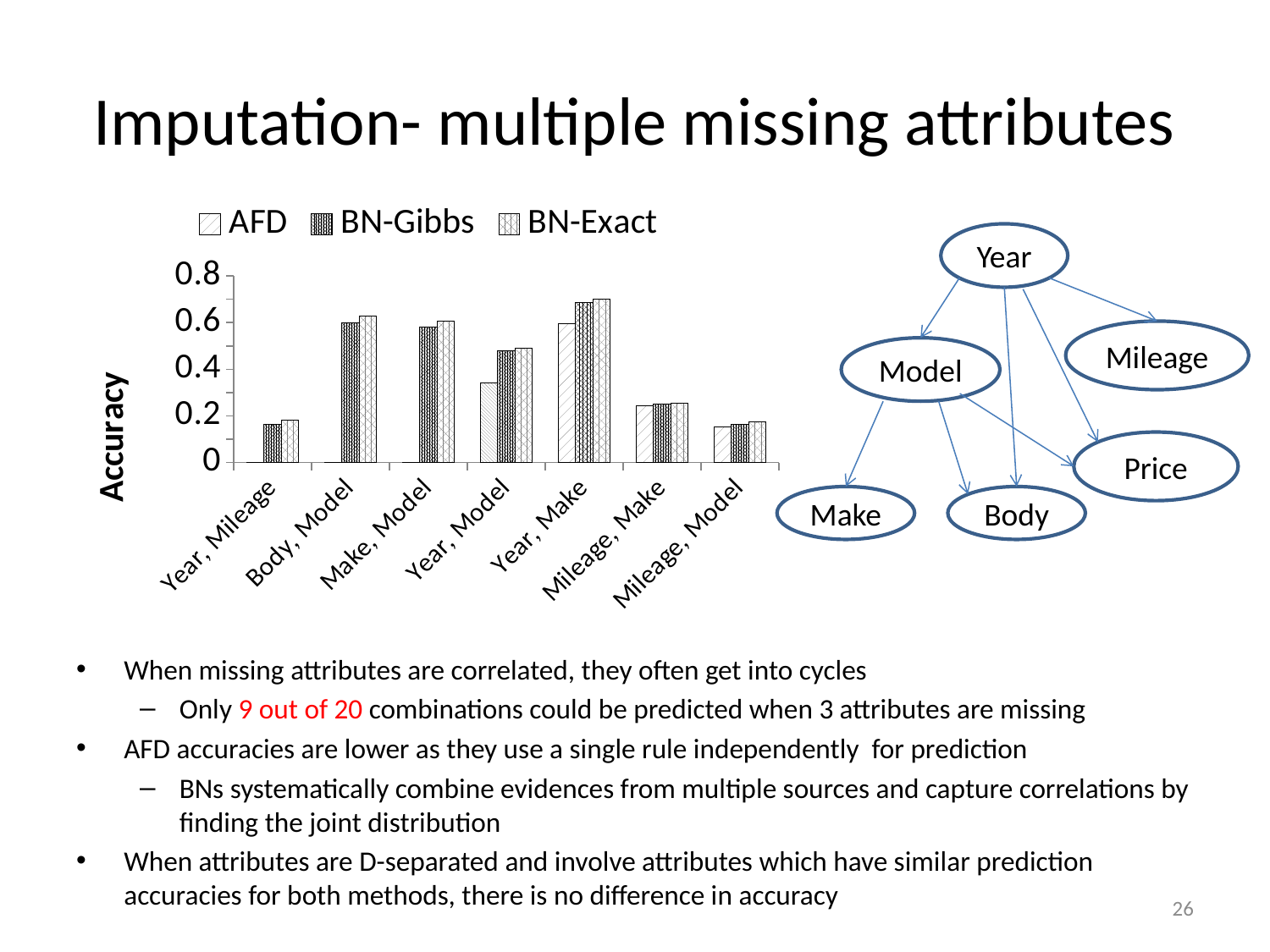
For the Year, Model category, which is larger: the AFD accuracy or the BN-Gibbs accuracy? BN-Gibbs Is the BN-Gibbs accuracy for Body, Model greater or less than 0.4? greater What kind of chart is shown on the slide? bar chart Is the BN-Exact accuracy for Year, Make greater or less than 0.6? greater Is the AFD accuracy for Year, Mileage greater or less than 0.2? less What are the three series named in the chart's legend? AFD, BN-Gibbs, BN-Exact How many series does the chart's legend list? 3 What is the title of the vertical axis of the chart? Accuracy How many attribute-pair categories are shown on the x axis of the chart? 7 Which is larger: the AFD accuracy for Year, Make or the AFD accuracy for Mileage, Make? Year, Make Which category has the highest BN-Exact accuracy? Year, Make